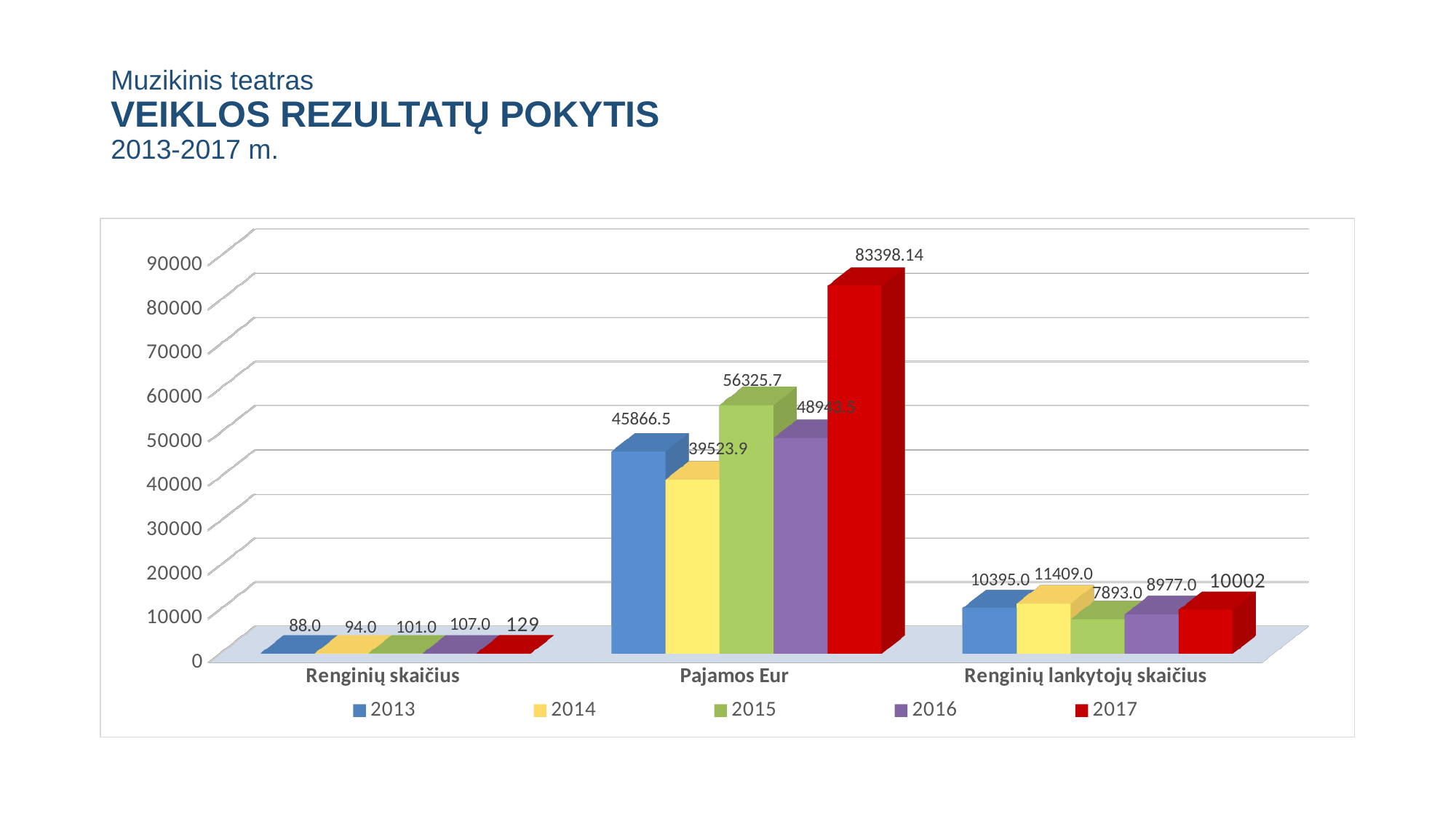
What kind of chart is shown on the slide? bar chart Which year has the lowest value in the Renginių lankytojų skaičius category? 2015 Which colour represents the 2017 series in the legend? red Do the values in the Renginių skaičius category rise or fall from 2013 to 2017? rise How many categories are shown on the x axis? 3 Which year has the highest value in the Pajamos Eur category? 2017 How many series does the legend list? 5 In the Pajamos Eur category, which is larger: the value for 2013 or the value for 2014? 2013 What is the value for 2017 in the Pajamos Eur category? 83398.14 What is the value for 2014 in the Renginių skaičius category? 94.0 What is the difference between the 2017 and 2013 values in the Renginių skaičius category? 41 What is the value for 2015 in the Renginių lankytojų skaičius category? 7893.0